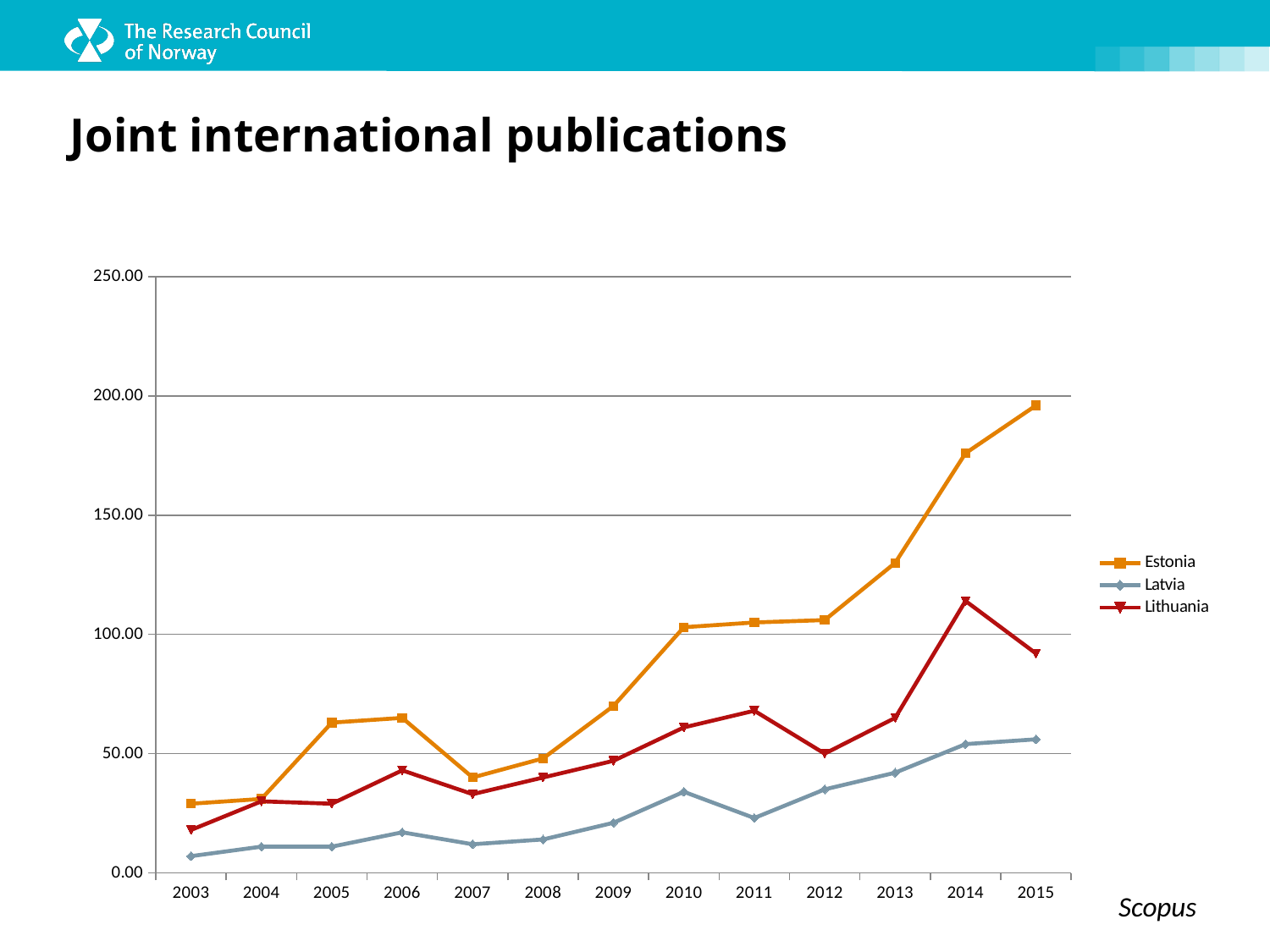
Does the value for Latvia generally rise or fall from 2003 to 2015? rise In which year does Latvia have its lowest value? 2003 Which is larger in 2012, the value for Latvia or the value for Lithuania? Lithuania How many series does the legend list? 3 Is the value for Lithuania in 2015 greater or less than 100? less Which series has the highest value in 2015? Estonia Is the value for Latvia in 2003 greater or less than 50? less Is the value for Estonia in 2015 greater or less than 150? greater In which year does Lithuania reach its highest value? 2014 What is the title of the slide containing the chart? Joint international publications How many years are shown on the x axis? 13 What kind of chart is shown on the slide? line chart